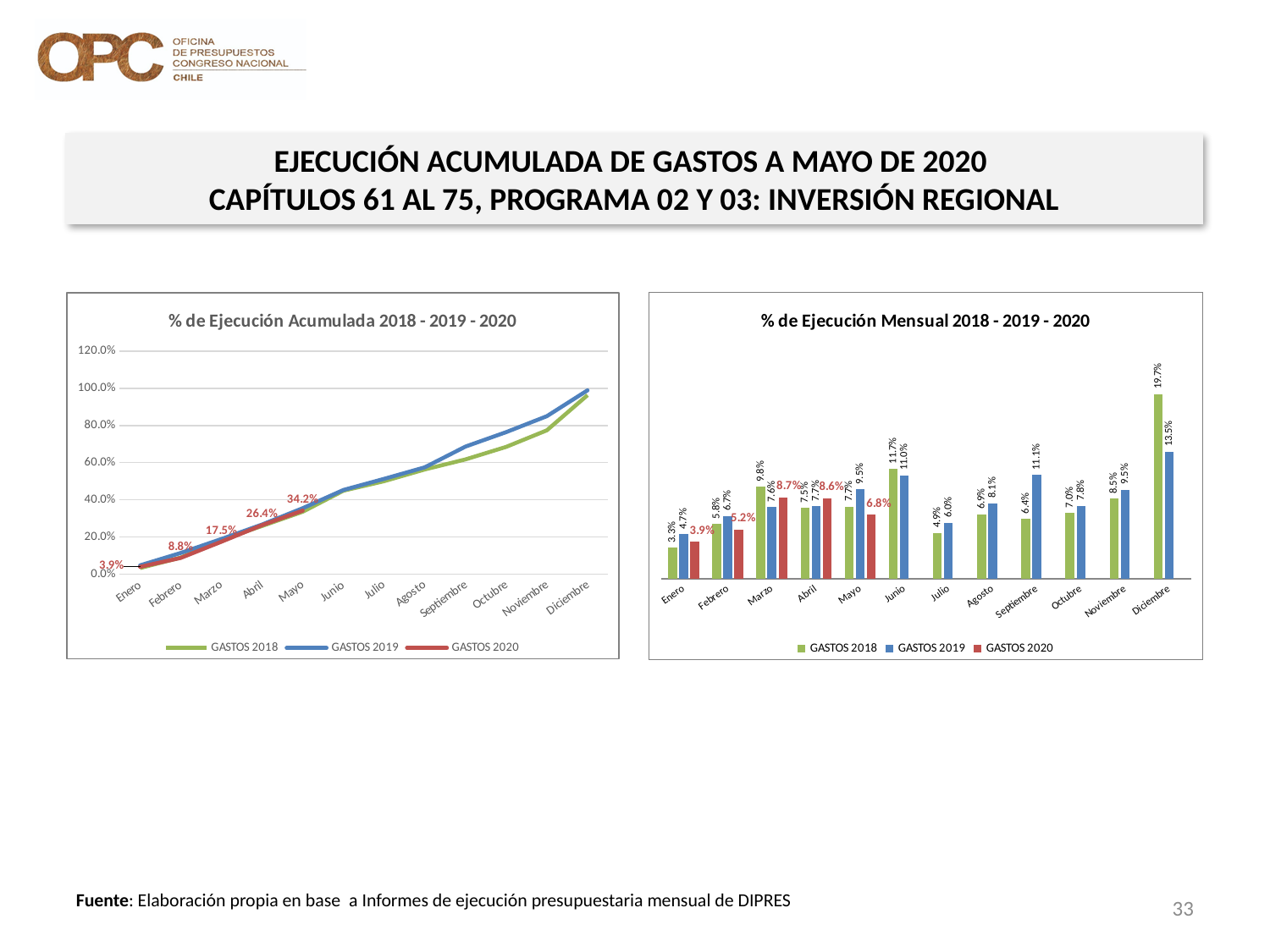
What kind of chart is the chart titled '% de Ejecución Mensual 2018 - 2019 - 2020'? bar chart In the chart titled '% de Ejecución Acumulada 2018 - 2019 - 2020', do the values for GASTOS 2018 rise or fall from Enero to Diciembre? rise In the chart titled '% de Ejecución Mensual 2018 - 2019 - 2020', which month has the highest value for GASTOS 2018? Diciembre In the chart titled '% de Ejecución Acumulada 2018 - 2019 - 2020', what is the value for GASTOS 2020 in Mayo? 34.2% In the chart titled '% de Ejecución Mensual 2018 - 2019 - 2020', which month has the lowest value for GASTOS 2019? Enero In the chart titled '% de Ejecución Acumulada 2018 - 2019 - 2020', is the value for GASTOS 2019 in Noviembre greater or less than 80.0%? greater In the chart titled '% de Ejecución Acumulada 2018 - 2019 - 2020', what is the difference between the GASTOS 2020 values for Abril and Febrero? 17.6% In the chart titled '% de Ejecución Mensual 2018 - 2019 - 2020', which is larger in Marzo: GASTOS 2018 or GASTOS 2020? GASTOS 2018 How many series does the legend of the chart titled '% de Ejecución Mensual 2018 - 2019 - 2020' list? 3 In the chart titled '% de Ejecución Acumulada 2018 - 2019 - 2020', what is the value for GASTOS 2020 in Marzo? 17.5% In the chart titled '% de Ejecución Mensual 2018 - 2019 - 2020', what is the value for GASTOS 2019 in Septiembre? 11.1% In the chart titled '% de Ejecución Mensual 2018 - 2019 - 2020', what is the difference between GASTOS 2018 and GASTOS 2019 in Diciembre? 6.2%